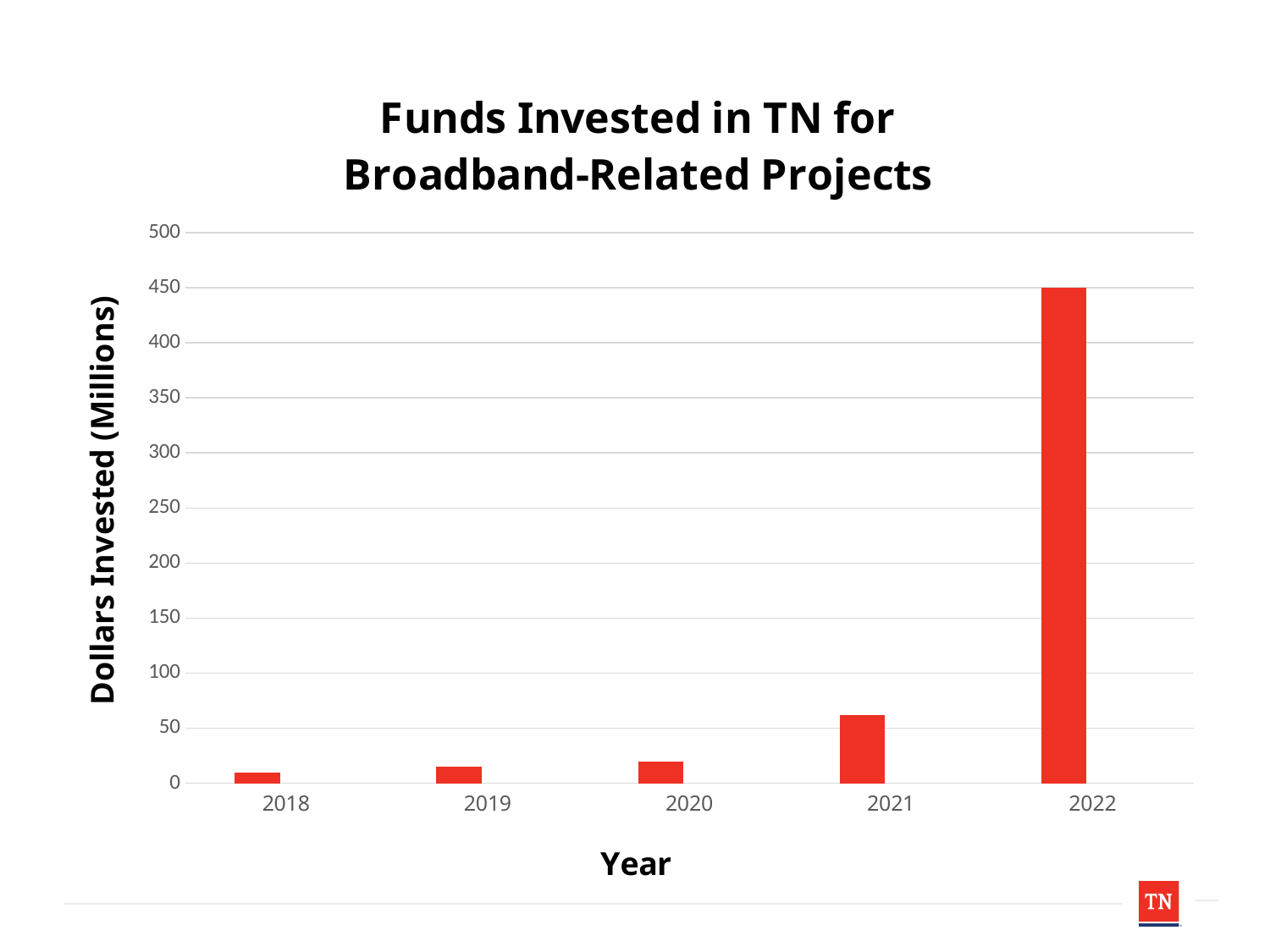
Is the value for 2021 greater or less than 100? less What is the title of the chart? Funds Invested in TN for Broadband-Related Projects How many years are shown on the x axis of the chart? 5 What kind of chart is shown on the slide? bar chart What is the value for 2022 in the chart? 450 Do the values rise or fall from 2018 to 2022? rise Which year has the larger value, 2020 or 2021? 2021 Is the value for 2018 greater or less than 50? less Is the value for 2022 greater or less than 400? greater Which year has the highest dollars invested? 2022 What is the label on the vertical axis of the chart? Dollars Invested (Millions)